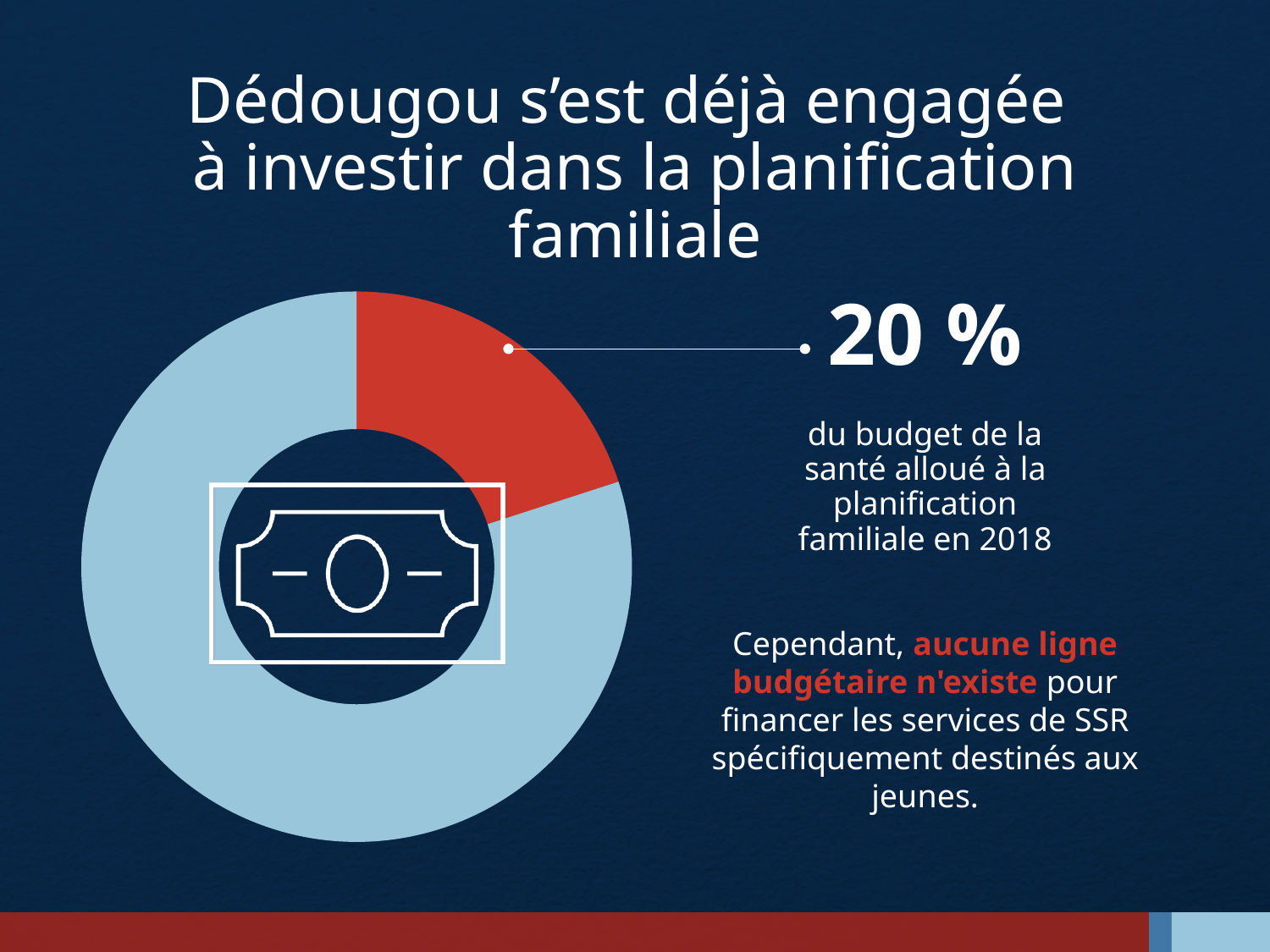
Is the share of the red slice greater or less than 50 %? less Which year does the 20 % figure in the chart refer to? 2018 Which slice of the pie chart is larger, the red one or the light blue one? The light blue one What kind of chart is shown on the slide? Pie chart (donut) What percentage of the health budget was allocated to family planning in 2018 according to the chart? 20 % What share of the pie does the light blue slice represent? 80 % What colour is the slice labelled 20 %? Red What share of the pie does the red slice represent? 20 % Which slice of the pie chart is the smallest? The red slice (20 %) How many slices does the pie chart have? 2